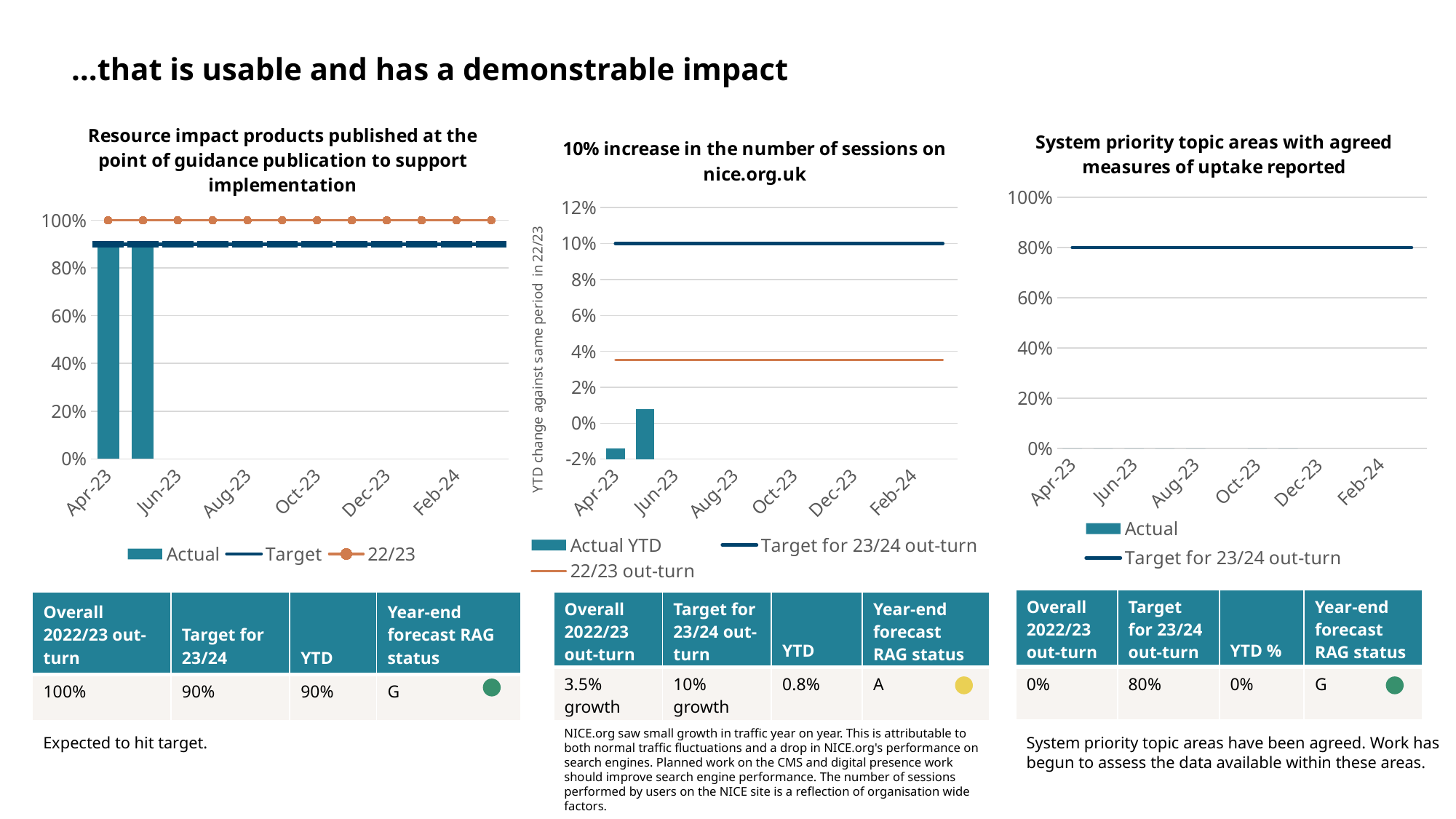
In the 'Resource impact products published at the point of guidance publication to support implementation' chart, at what value does the '22/23' line sit? 100% In the '10% increase in the number of sessions on nice.org.uk' chart, is the Actual YTD value for Apr-23 greater or less than 0%? less How many series does the legend list for the 'System priority topic areas with agreed measures of uptake reported' chart? 2 In the '10% increase in the number of sessions on nice.org.uk' chart, at what value does the 'Target for 23/24 out-turn' line sit? 10% What kind of chart is the 'Resource impact products published at the point of guidance publication to support implementation' chart? Bar chart with line series In the 'System priority topic areas with agreed measures of uptake reported' chart, at what value does the 'Target for 23/24 out-turn' line sit? 80% In the '10% increase in the number of sessions on nice.org.uk' chart, which line is higher, 'Target for 23/24 out-turn' or '22/23 out-turn'? Target for 23/24 out-turn In the 'Resource impact products published at the point of guidance publication to support implementation' chart, is the Actual value for Apr-23 greater or less than 80%? greater What is the y-axis title of the '10% increase in the number of sessions on nice.org.uk' chart? YTD change against same period in 22/23 In the '10% increase in the number of sessions on nice.org.uk' chart, which month has the larger Actual YTD bar, Apr-23 or May-23? May-23 In the 'Resource impact products published at the point of guidance publication to support implementation' chart, how many months have an Actual bar plotted? 2 How many series does the legend list for the 'Resource impact products published at the point of guidance publication to support implementation' chart? 3